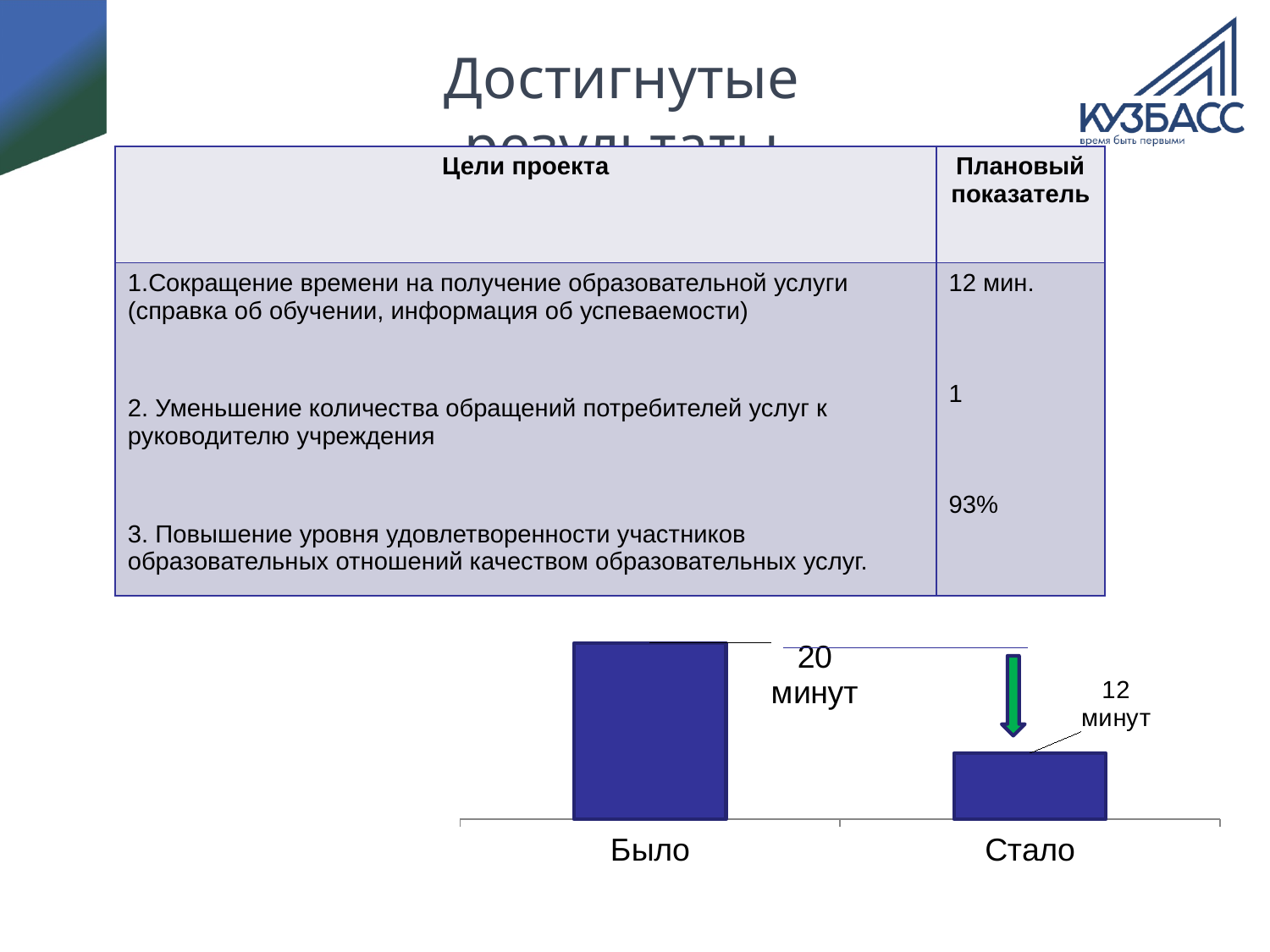
By how many minutes does the "Было" value exceed the "Стало" value? 8 минут What kind of chart is shown at the bottom of the slide? bar chart Which category has the highest bar in the chart? Было Do the values rise or fall from "Было" to "Стало" along the x axis? fall Which category has the lowest bar in the chart? Стало How many categories are shown on the x axis of the bar chart? 2 What is the value labelled for the "Стало" bar? 12 минут What are the two category labels on the x axis of the bar chart? Было, Стало What colour are the bars in the chart? blue Which is larger, the value for "Было" or the value for "Стало"? Было What is the value labelled for the "Было" bar? 20 минут